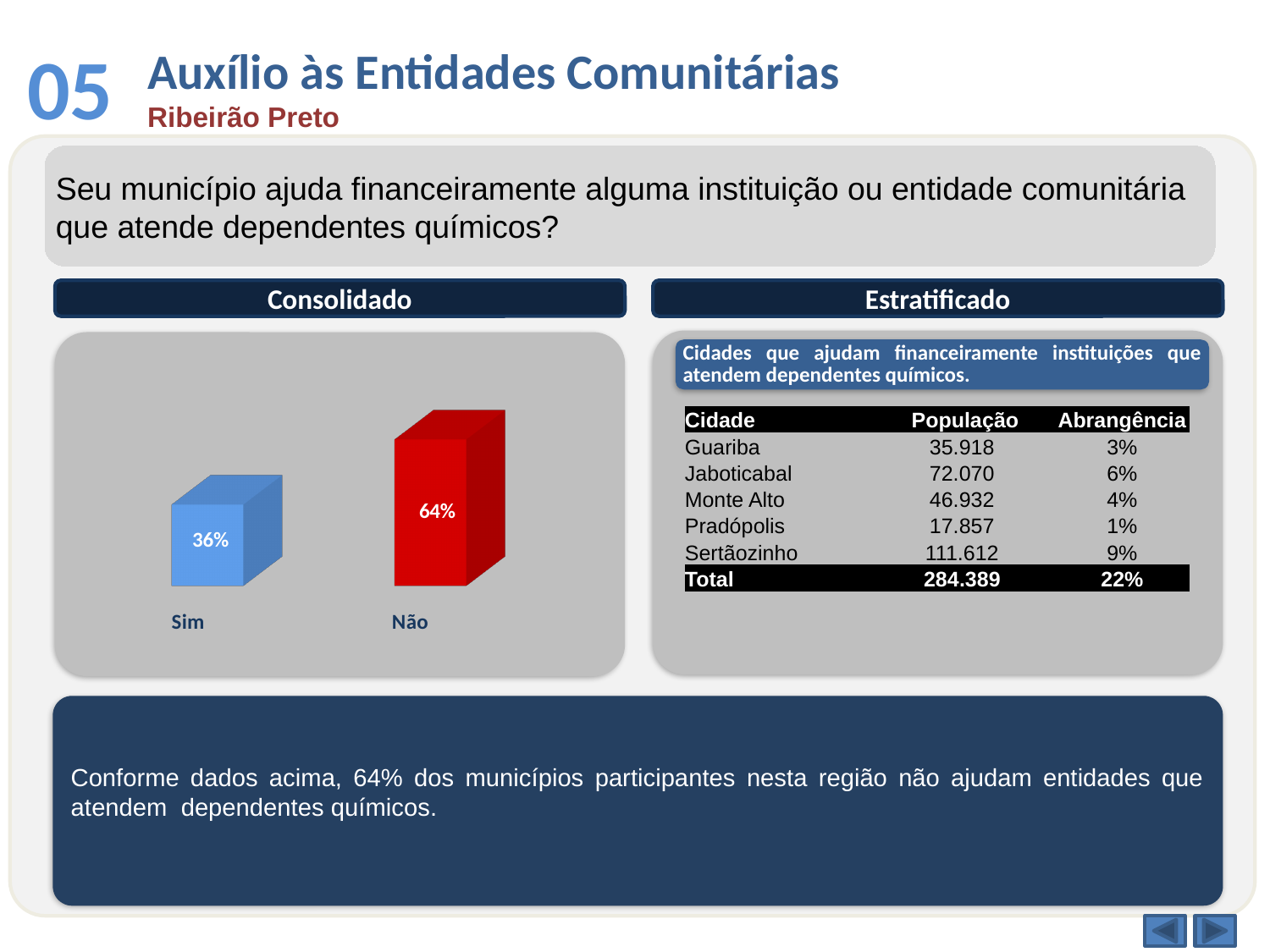
In the Consolidado chart, what colour is the bar for Não? Red In the Consolidado chart, what is the total of the values for Sim and Não? 100% In the Consolidado chart, what is the value for Sim? 36% How many categories are shown in the Consolidado chart? 2 What kind of chart is the Consolidado chart? Bar chart In the Consolidado chart, what is the difference between the values for Não and Sim? 28% In the Consolidado chart, which category has the highest value? Não In the Consolidado chart, which category has the lowest value? Sim In the Consolidado chart, what is the value for Não? 64% In the Consolidado chart, what colour is the bar for Sim? Blue In the Consolidado chart, which is larger, the value for Sim or the value for Não? Não